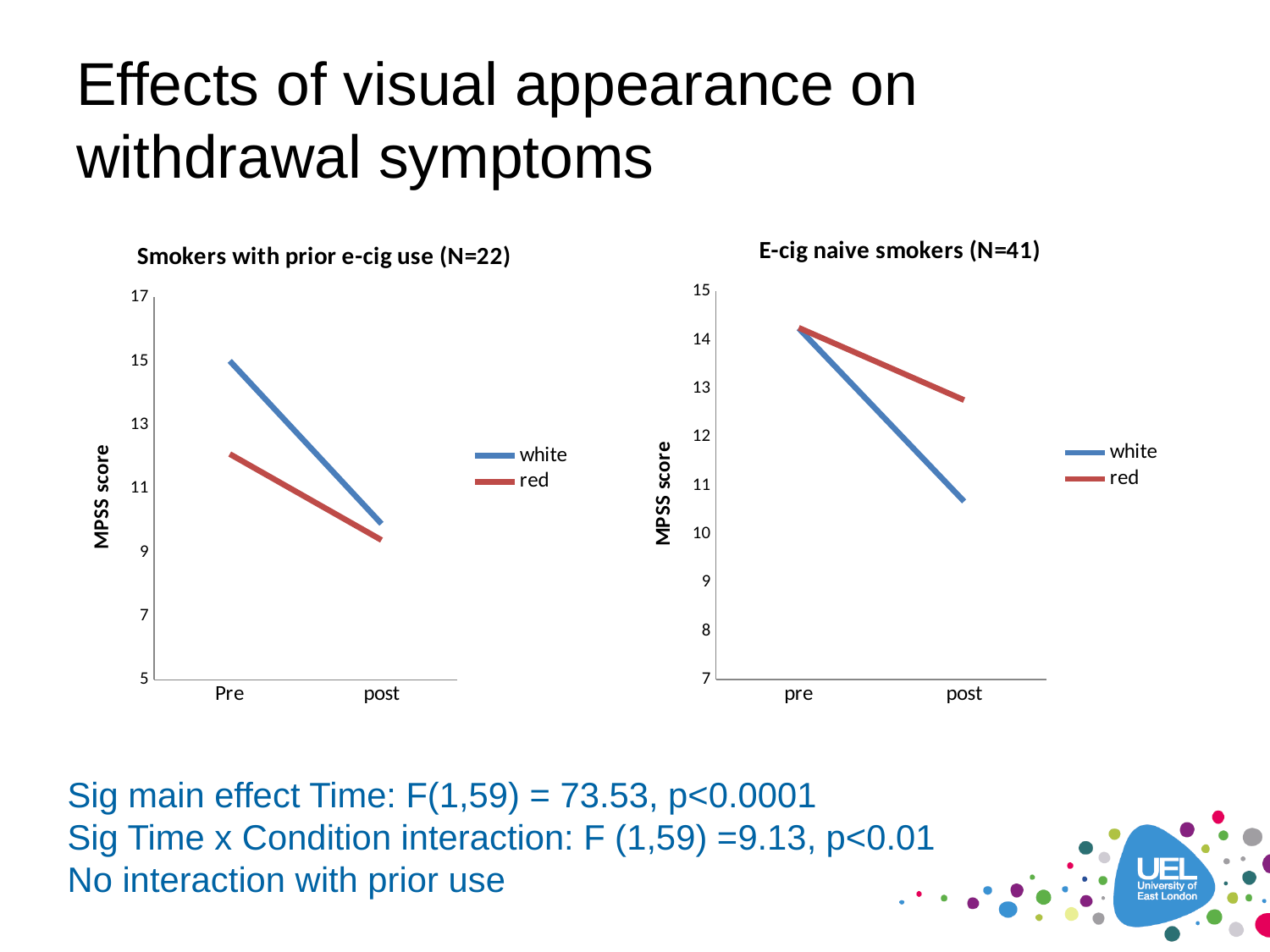
In the 'Smokers with prior e-cig use (N=22)' chart, is the value for red at Pre greater or less than 13? less In the 'Smokers with prior e-cig use (N=22)' chart, which series has the higher value at Pre, white or red? white In the 'Smokers with prior e-cig use (N=22)' chart, how many points are on the x axis? 2 In the 'E-cig naive smokers (N=41)' chart, is the value for red at post greater or less than 13? less What is the y-axis label of the 'E-cig naive smokers (N=41)' chart? MPSS score In the 'E-cig naive smokers (N=41)' chart, does the white series rise or fall from pre to post? fall In the 'Smokers with prior e-cig use (N=22)' chart, is the value for white at Pre greater or less than 13? greater In the 'E-cig naive smokers (N=41)' chart, which series has the higher value at post, white or red? red How many series does the legend of the 'E-cig naive smokers (N=41)' chart list? 2 What kind of chart is the 'Smokers with prior e-cig use (N=22)' chart? line chart